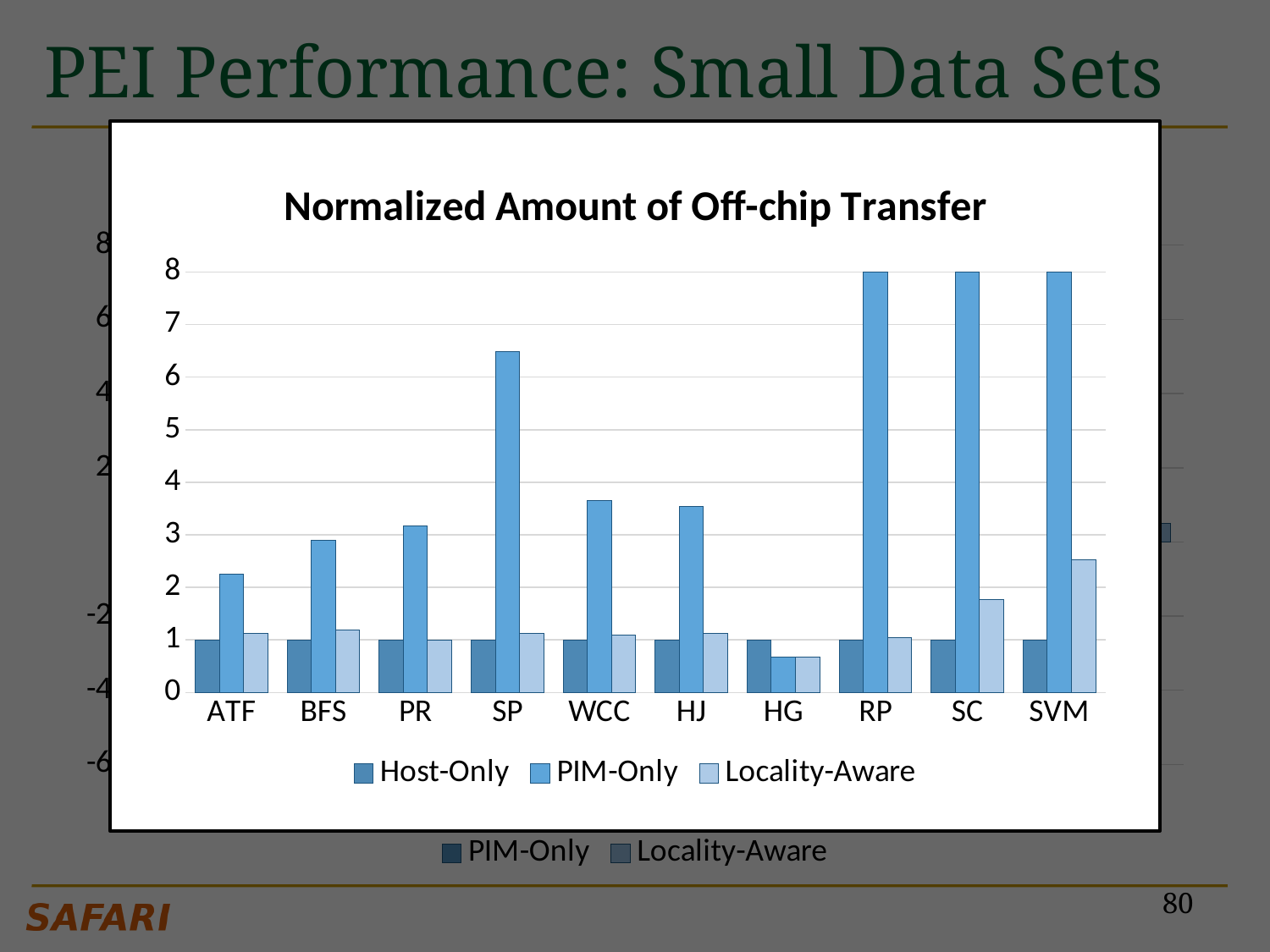
How many categories are shown on the x axis of the chart? 10 Is the PIM-Only value for SP greater or less than 6? greater Is the PIM-Only value for HG greater or less than 1? less Which category has the lowest PIM-Only value? HG Which category has the highest Locality-Aware value? SVM How many series does the chart's legend list? 3 Is the PIM-Only value for RP greater or less than 7? greater Which is larger, the Locality-Aware value for SC or the Locality-Aware value for SVM? SVM Which is larger, the PIM-Only value for SP or the PIM-Only value for WCC? SP What is the title of the chart on the slide? Normalized Amount of Off-chip Transfer What kind of chart is shown on the slide? bar chart